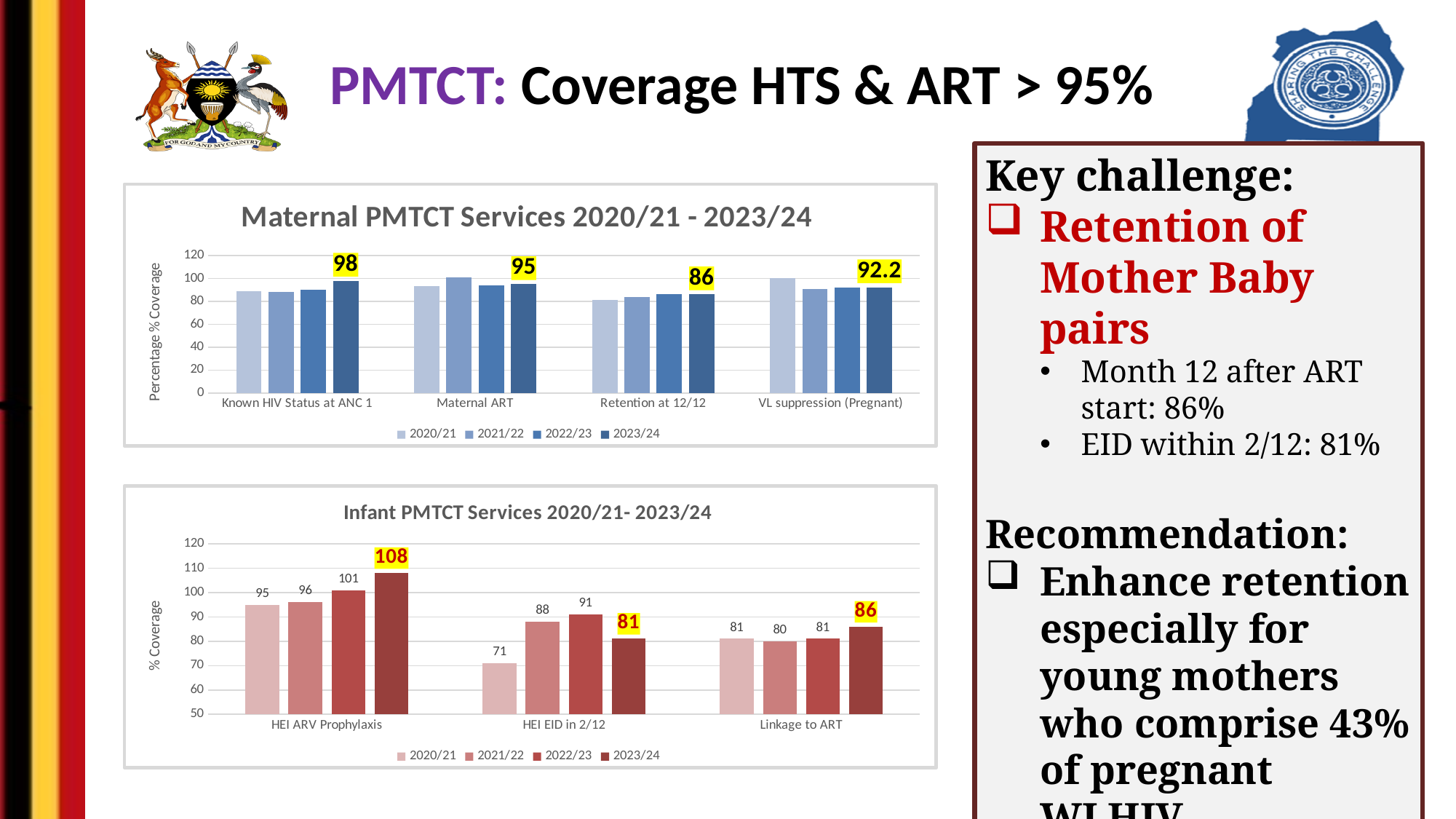
What kind of chart is the 'Infant PMTCT Services 2020/21- 2023/24' chart? bar chart In the 'Infant PMTCT Services 2020/21- 2023/24' chart, what is the value for HEI EID in 2/12 in 2020/21? 71 In the 'Maternal PMTCT Services 2020/21 - 2023/24' chart, is the 2020/21 value for Retention at 12/12 greater or less than 100? less In the 'Maternal PMTCT Services 2020/21 - 2023/24' chart, which category has the lowest 2023/24 value? Retention at 12/12 In the 'Infant PMTCT Services 2020/21- 2023/24' chart, what is the value for HEI ARV Prophylaxis in 2023/24? 108 In the 'Maternal PMTCT Services 2020/21 - 2023/24' chart, what is the value for Known HIV Status at ANC 1 in 2023/24? 98 In the 'Maternal PMTCT Services 2020/21 - 2023/24' chart, how many series does the legend list? 4 In the 'Infant PMTCT Services 2020/21- 2023/24' chart, which is larger: Linkage to ART in 2021/22 or Linkage to ART in 2023/24? 2023/24 In the 'Infant PMTCT Services 2020/21- 2023/24' chart, what is the difference between the 2022/23 and 2023/24 values for HEI EID in 2/12? 10 In the 'Infant PMTCT Services 2020/21- 2023/24' chart, do the values for HEI ARV Prophylaxis rise or fall from 2020/21 to 2023/24? rise In the 'Infant PMTCT Services 2020/21- 2023/24' chart, how many categories are shown on the x axis? 3 In the 'Maternal PMTCT Services 2020/21 - 2023/24' chart, what is the 2023/24 value for VL suppression (Pregnant)? 92.2